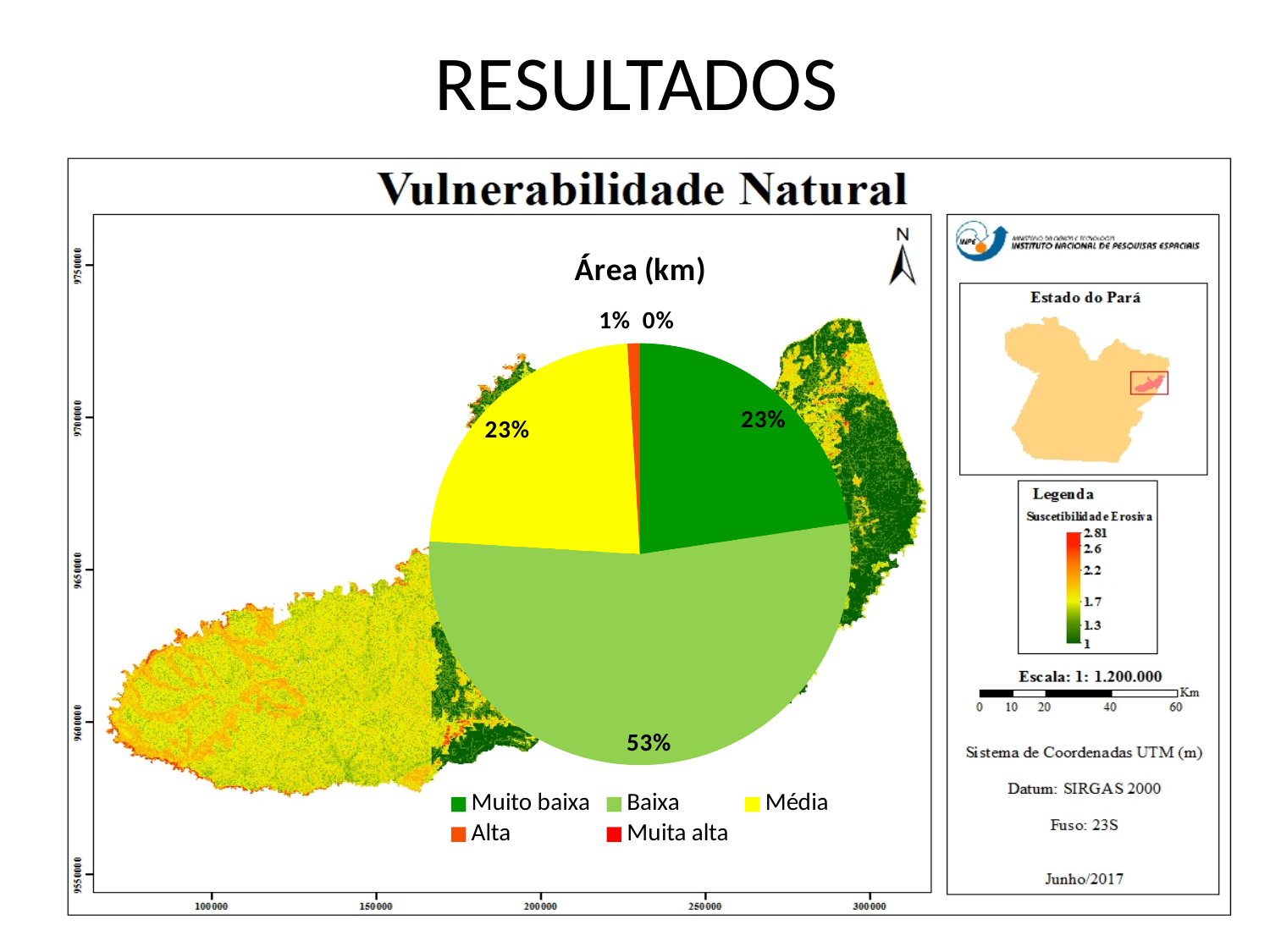
Which is larger, the Baixa slice or the Média slice? Baixa What share of the pie does the Alta slice represent? 1% What is the title of the pie chart? Área (km) What share of the pie does the Muita alta slice represent? 0% What share of the pie does the Média slice represent? 23% Which category has the smallest slice of the pie? Muita alta What is the difference in percentage points between the Baixa slice and the Muito baixa slice? 30% What kind of chart is shown on the slide? pie chart Which category has the largest slice of the pie? Baixa How many categories does the legend of the pie chart list? 5